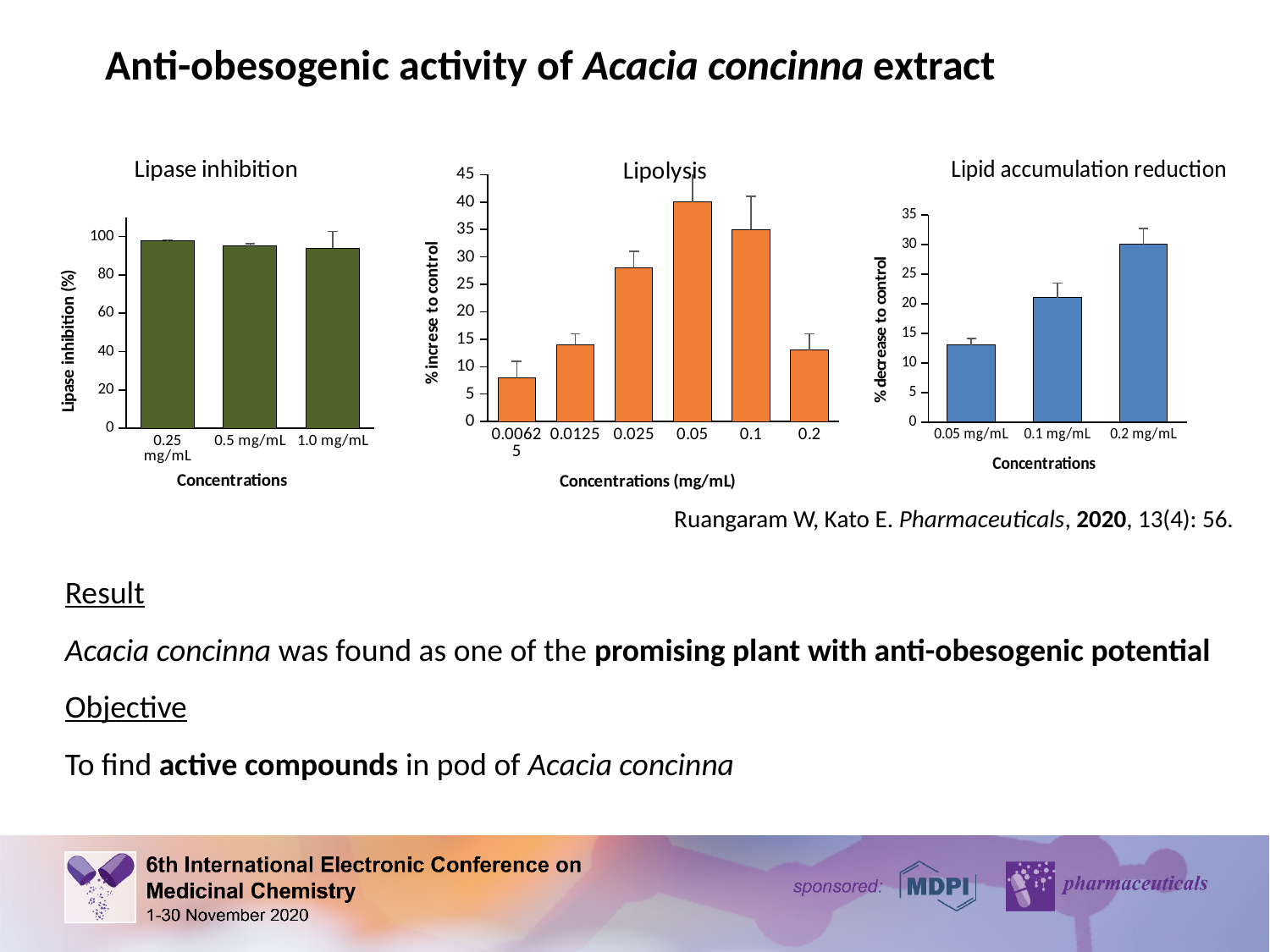
What kind of chart is the Lipolysis chart? bar chart On the Lipid accumulation reduction chart, is the value for 0.05 mg/mL greater or less than 15? less On the Lipolysis chart, what is the % increase to control at 0.05 mg/mL? 40 On the Lipolysis chart, which is larger, the value for 0.025 or the value for 0.1? 0.1 On the Lipid accumulation reduction chart, which concentration has the highest % decrease to control? 0.2 mg/mL On the Lipolysis chart, which concentration has the lowest % increase to control? 0.00625 On the Lipolysis chart, is the value for 0.025 greater or less than 25? greater How many concentrations are shown on the Lipase inhibition chart? 3 On the Lipase inhibition chart, is the value for 0.25 mg/mL greater or less than 80? greater On the Lipolysis chart, which concentration has the highest % increase to control? 0.05 On the Lipid accumulation reduction chart, do the values rise or fall as concentration increases along the x axis? rise How many concentrations are shown on the Lipolysis chart? 6